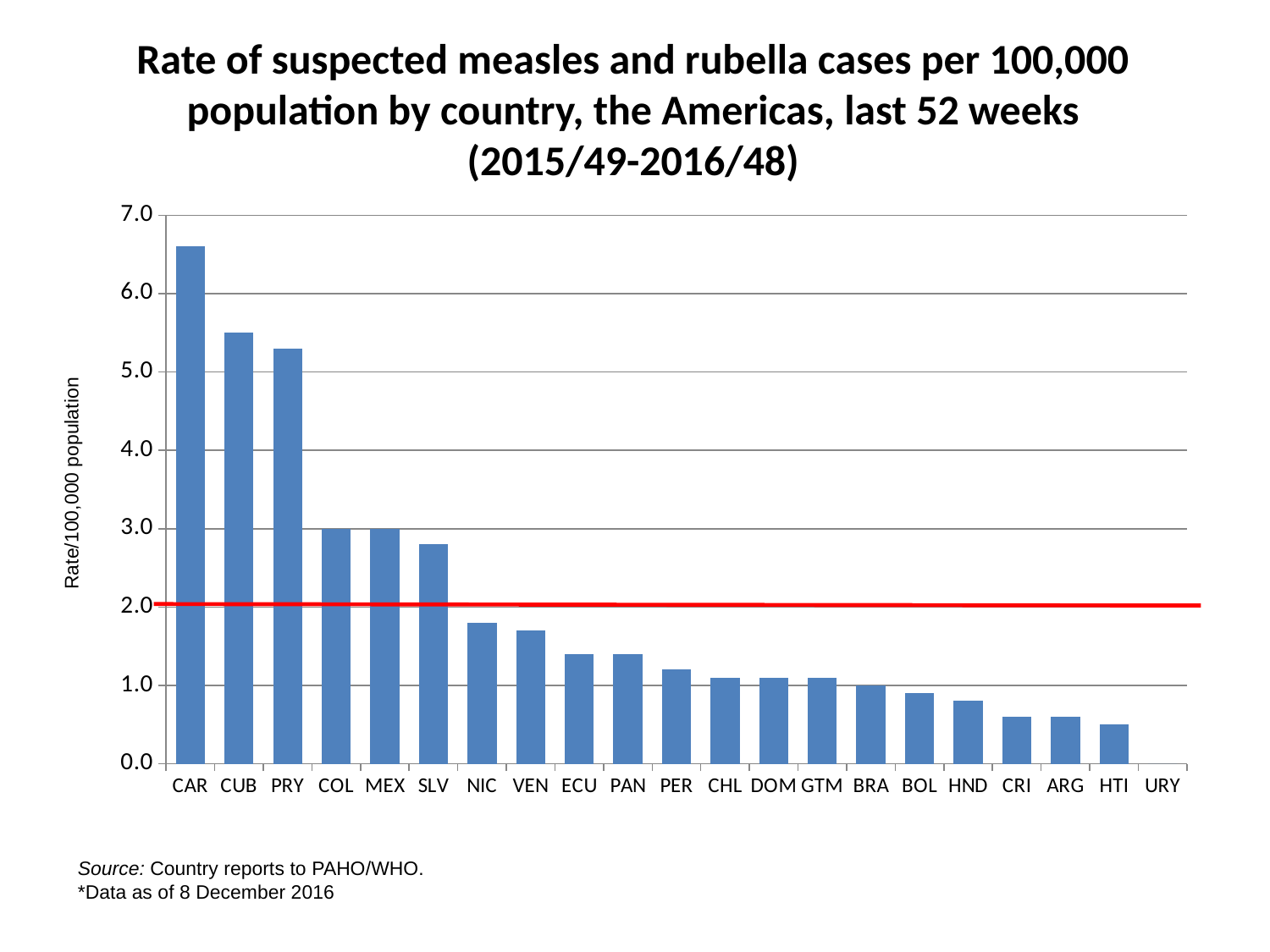
Is the value for NIC greater or less than 2.0? less Is the value for CAR greater or less than 6.0? greater Which country has the lowest rate, with no visible bar? URY What kind of chart is shown on the slide? Bar chart Which has a higher rate, CUB or COL? CUB Which country has the highest rate of suspected measles and rubella cases? CAR Is the value for HTI greater or less than 1.0? less How many countries are listed along the x axis of the chart? 21 At what value on the y axis is the red horizontal line drawn? 2.0 Do the bar values rise or fall moving from left to right along the x axis? fall